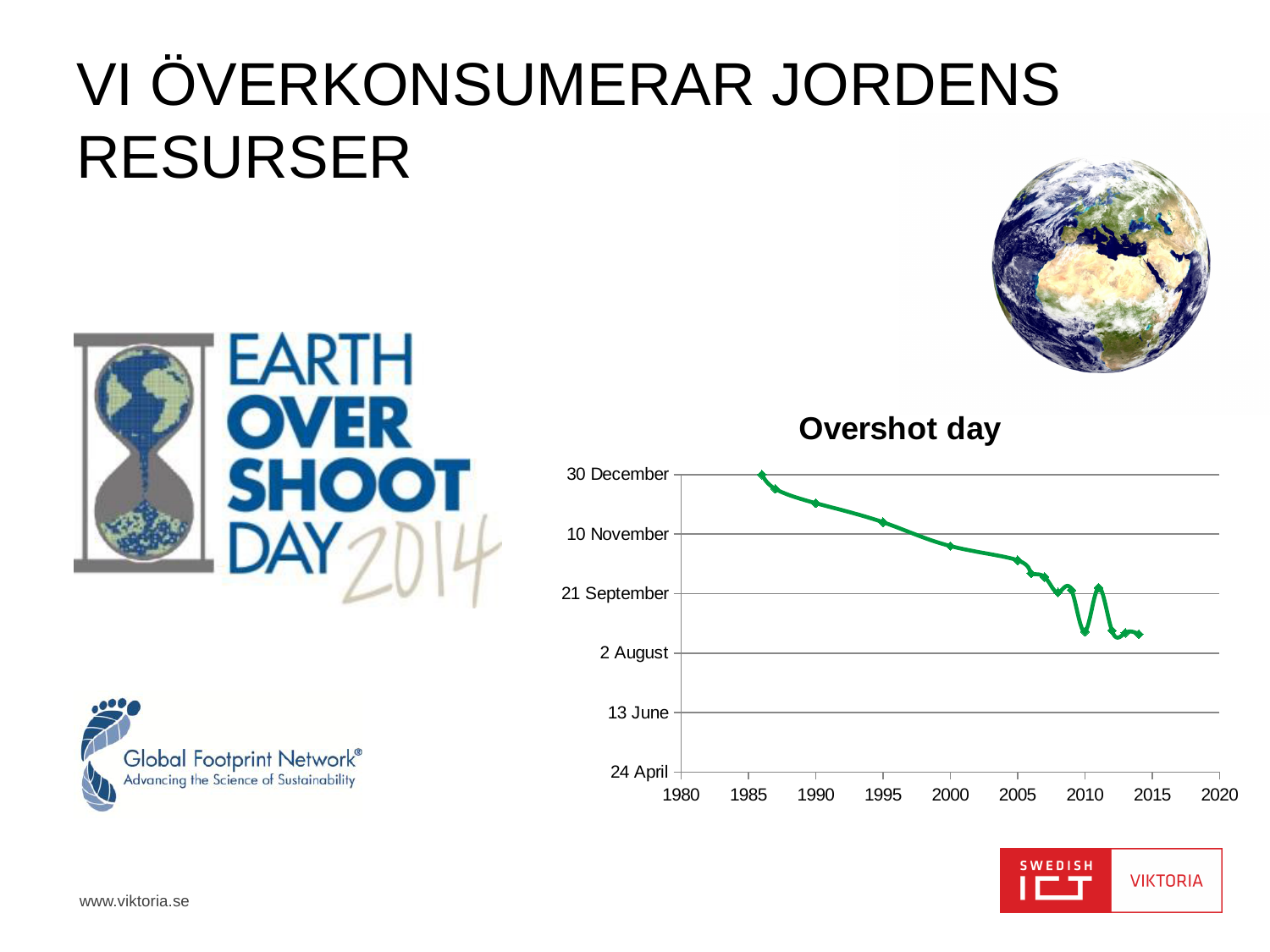
What is the earliest date label shown on the y axis of the chart? 24 April Is the overshoot day for 1990 later or earlier than 10 November? later What kind of chart is shown on the slide? line chart What is the title of the chart on the slide? Overshot day Does the overshoot day move to earlier or later dates as the years increase along the x axis? earlier Is the overshoot day for 2010 later or earlier than 21 September? earlier Is the overshoot day for 1995 later or earlier than 10 November? later Which is later, the overshoot day for 1990 or the overshoot day for 2005? 1990 What is the first year shown on the x axis of the chart? 1980